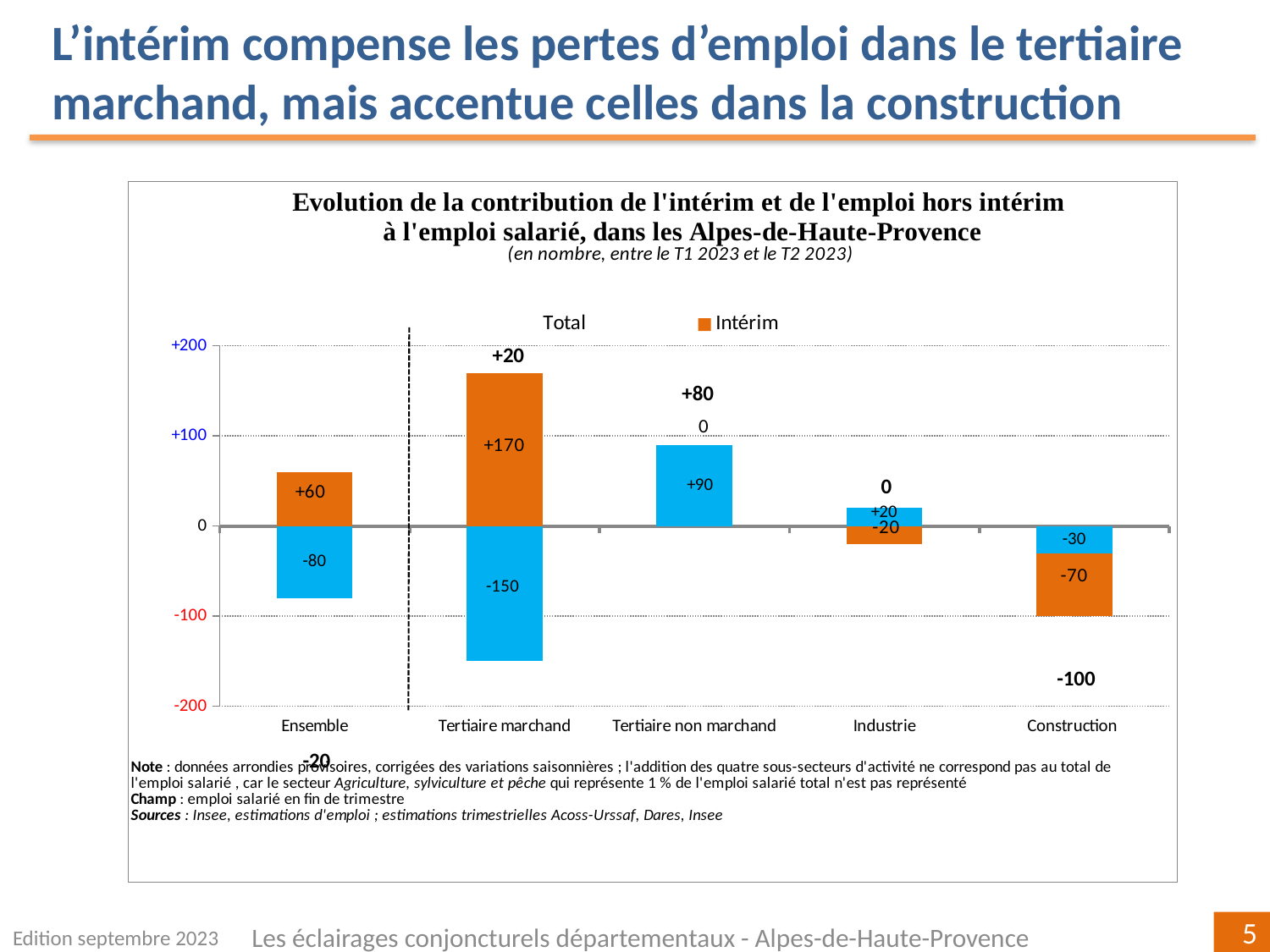
What is the Total value shown for Tertiaire marchand? +20 What is the difference between the Intérim value for Tertiaire marchand and the Intérim value for Ensemble? 110 What is the Intérim value for Tertiaire marchand? +170 What is the Intérim value for Construction? -70 How many sector categories are shown on the x axis? 5 What is the value of the blue bar for Tertiaire non marchand? +90 What is the Total value shown for Industrie? 0 Which category has the highest Intérim value? Tertiaire marchand Which category has the lowest Intérim value? Construction What is the Total value shown for Construction? -100 What kind of chart is shown on the slide? bar chart Which is larger, the Intérim value for Ensemble or for Industrie? Ensemble